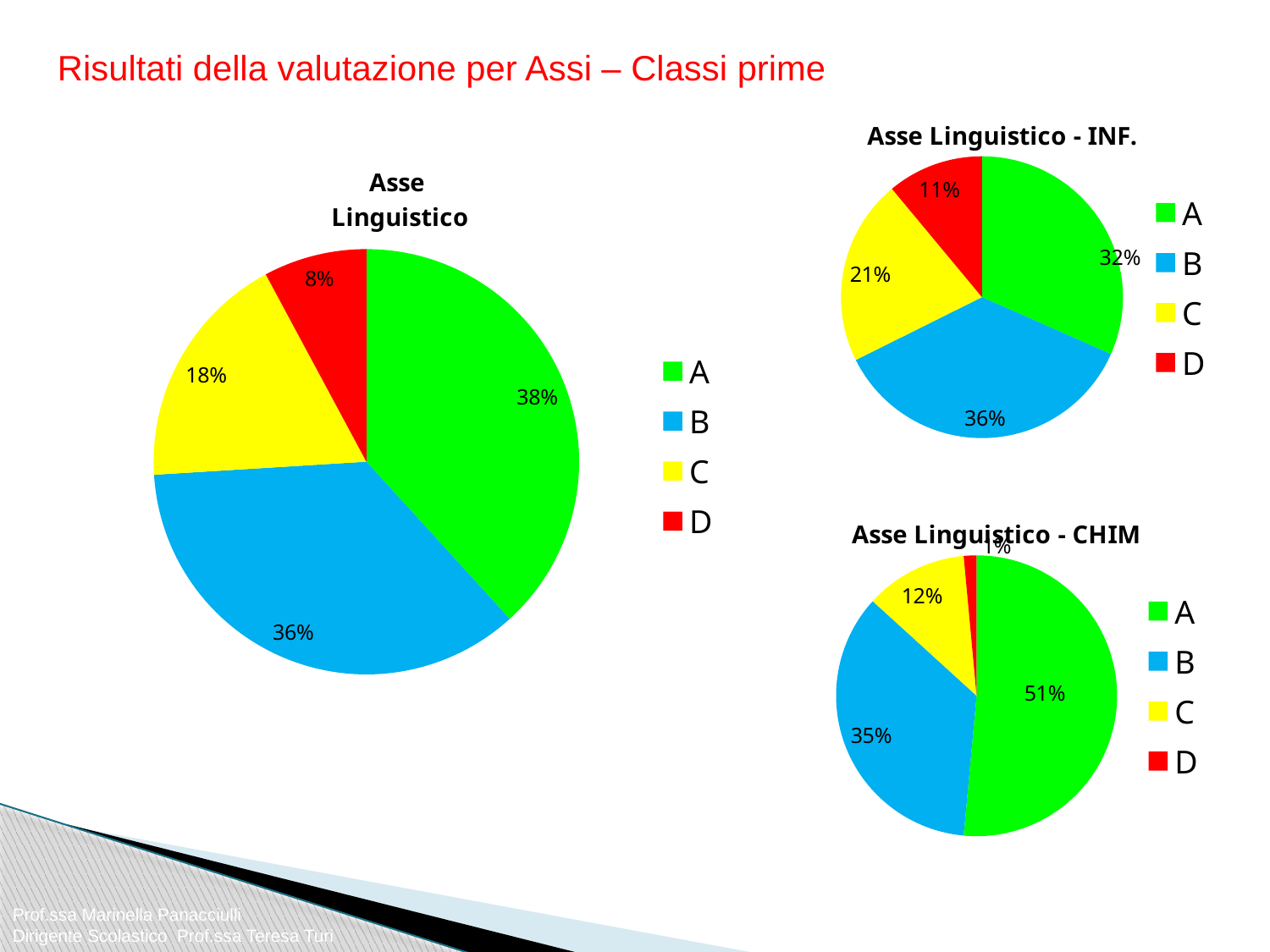
In the "Asse Linguistico" pie chart, what share does category A have? 38% What type of chart is "Asse Linguistico - INF."? Pie chart In the "Asse Linguistico - CHIM" pie chart, which is larger, category B or category C? B In the "Asse Linguistico - CHIM" pie chart, what share does category A have? 51% In the "Asse Linguistico - INF." pie chart, what is the difference in percentage points between category B and category A? 4 In the "Asse Linguistico" pie chart, what colour represents category C? Yellow In the "Asse Linguistico" pie chart, which category has the smallest slice? D How many categories does the legend of the "Asse Linguistico - CHIM" chart list? 4 In the "Asse Linguistico - INF." pie chart, what share does category C have? 21% In the "Asse Linguistico - CHIM" pie chart, what share does category D have? 1% In the "Asse Linguistico" pie chart, what share does category D have? 8% In the "Asse Linguistico - INF." pie chart, which category has the largest slice? B